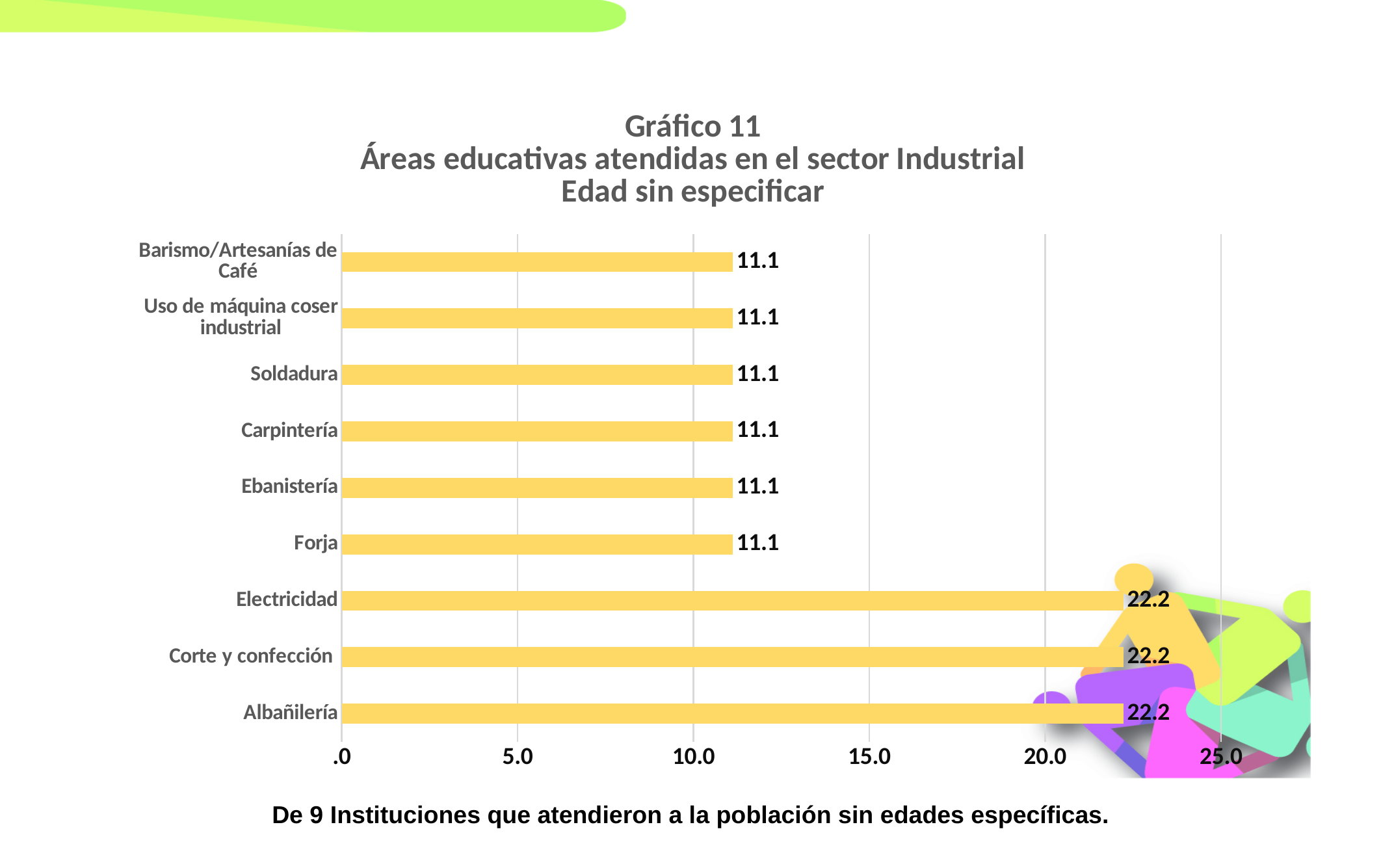
What is the value for Soldadura? 11.1 What is the value for Barismo/Artesanías de Café? 11.1 What is the value for Albañilería? 22.2 How many categories have a value of 22.2? 3 What is the title of the chart? Gráfico 11 Áreas educativas atendidas en el sector Industrial Edad sin especificar What is the difference between the values for Corte y confección and Forja? 11.1 Is the value for Electricidad greater or less than 20.0? greater What kind of chart is shown on the slide? bar chart What is the value for Electricidad? 22.2 How many categories are shown in the chart? 9 Which is larger, the value for Carpintería or the value for Albañilería? Albañilería Is the value for Ebanistería greater or less than 15.0? less